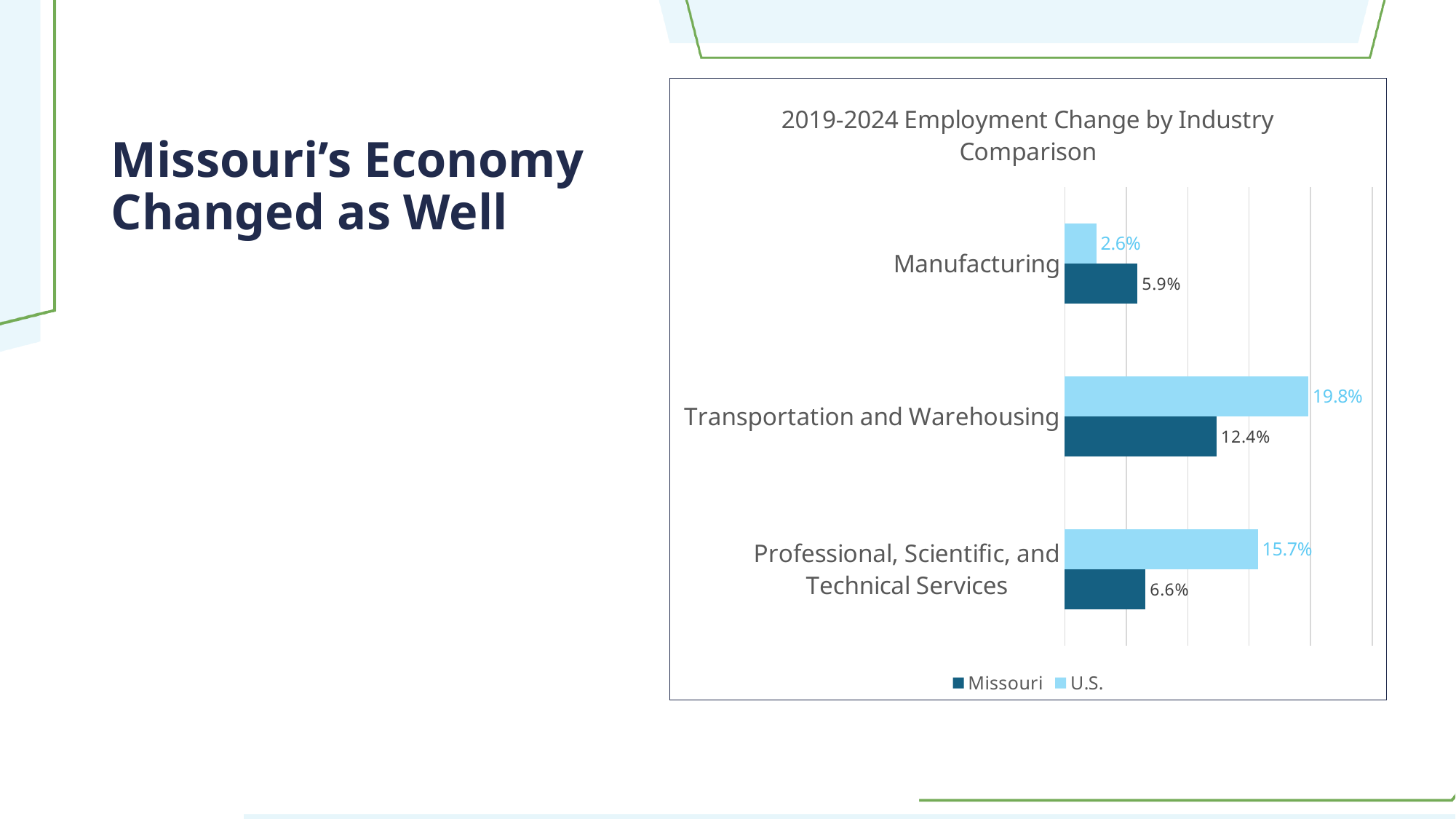
How many industries are shown in the chart? 3 What is the U.S. value for Manufacturing? 2.6% What is the U.S. value for Transportation and Warehousing? 19.8% What is the difference between the U.S. and Missouri values for Transportation and Warehousing? 7.4% Which industry has the lowest U.S. value? Manufacturing What is the Missouri value for Manufacturing? 5.9% Which industry has the highest Missouri value? Transportation and Warehousing What is the Missouri value for Professional, Scientific, and Technical Services? 6.6% What is the title of the chart? 2019-2024 Employment Change by Industry Comparison What kind of chart is shown on the slide? Bar chart How many series does the legend list? 2 Which is larger for Manufacturing, the Missouri value or the U.S. value? Missouri